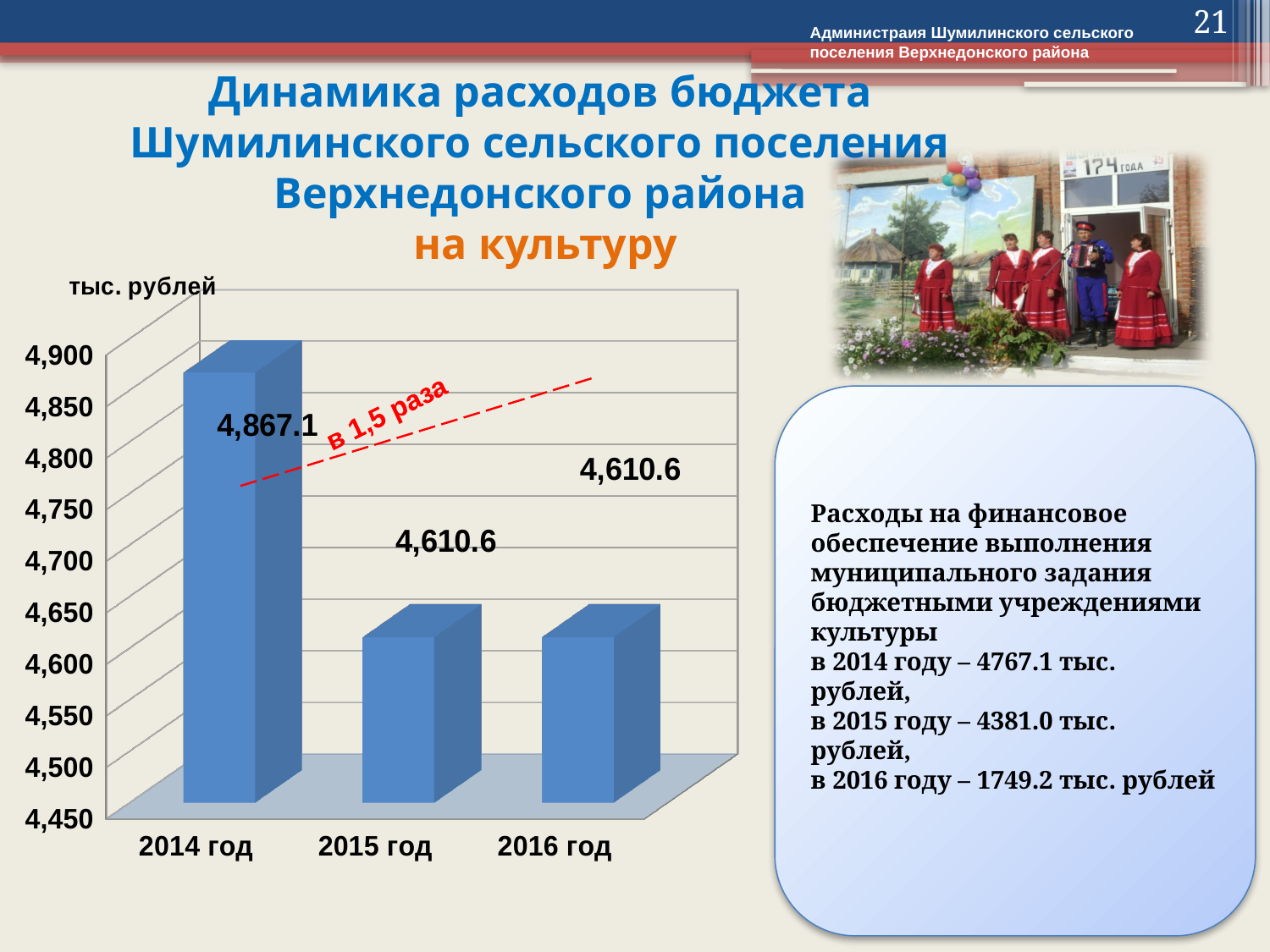
What is the value for 2014 год? 4,867.1 Is the value for 2015 год greater or less than 4,700? less Which is larger, the value for 2014 год or the value for 2016 год? 2014 год What kind of chart is shown on the slide? bar chart What is the value for 2016 год? 4,610.6 What is the value for 2015 год? 4,610.6 Do the values rise or fall from 2014 год to 2016 год? fall What is the difference between the values for 2014 год and 2015 год? 256.5 How many years are shown on the chart? 3 Is the value for 2014 год greater or less than 4,800? greater Which year has the highest value? 2014 год What unit is shown above the vertical axis of the chart? тыс. рублей